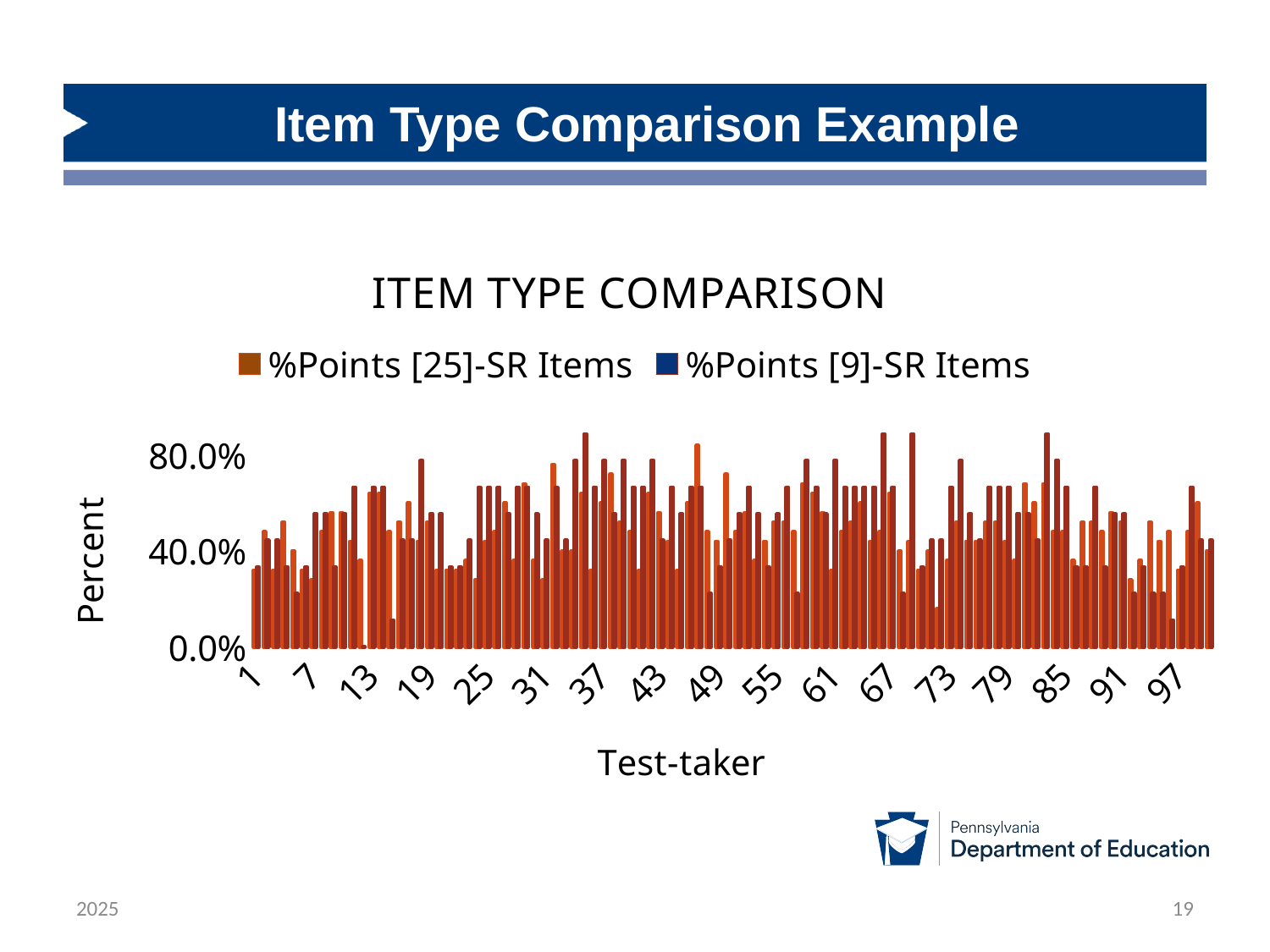
What kind of chart is shown on the slide? bar chart What are the two series named in the legend? %Points [25]-SR Items and %Points [9]-SR Items What is the title of the chart? ITEM TYPE COMPARISON Is the %Points [25]-SR Items value for test-taker 1 greater or less than 40.0%? less How many series does the legend list? 2